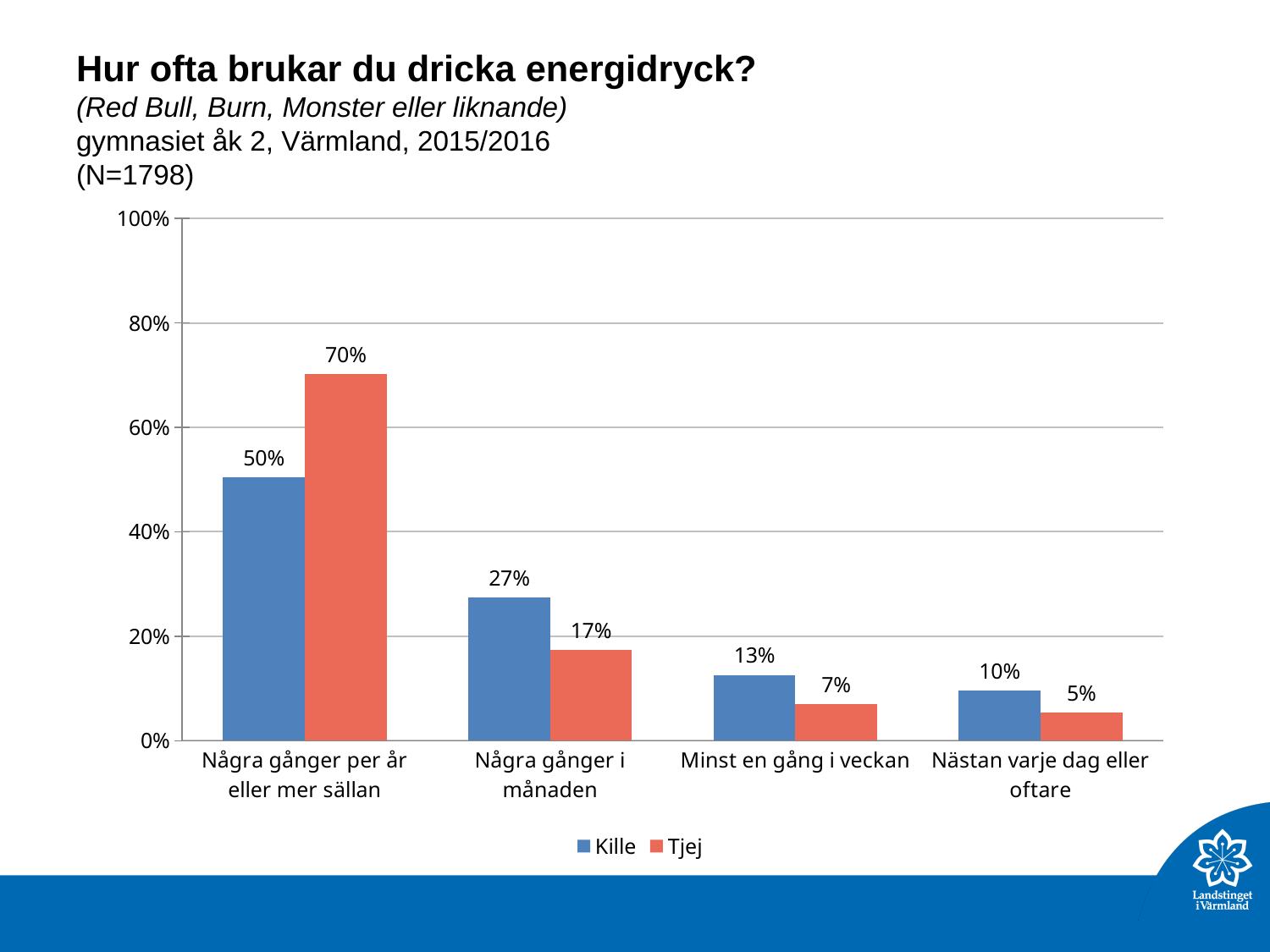
Do the Kille values rise or fall from left to right along the x axis? Fall Which category has the highest value for Tjej? Några gånger per år eller mer sällan What is the value for Tjej in the category "Några gånger i månaden"? 17% Is the value for Kille in "Några gånger i månaden" greater or less than 20%? greater How many categories are shown on the x axis? 4 What is the value for Kille in the category "Några gånger per år eller mer sällan"? 50% What kind of chart is shown on the slide? Bar chart What is the difference between the Tjej and Kille values in the category "Några gånger per år eller mer sällan"? 20% How many series does the legend list? 2 Which series has the larger value in the category "Minst en gång i veckan", Kille or Tjej? Kille What is the value for Tjej in the category "Nästan varje dag eller oftare"? 5% Which category has the lowest value for Kille? Nästan varje dag eller oftare